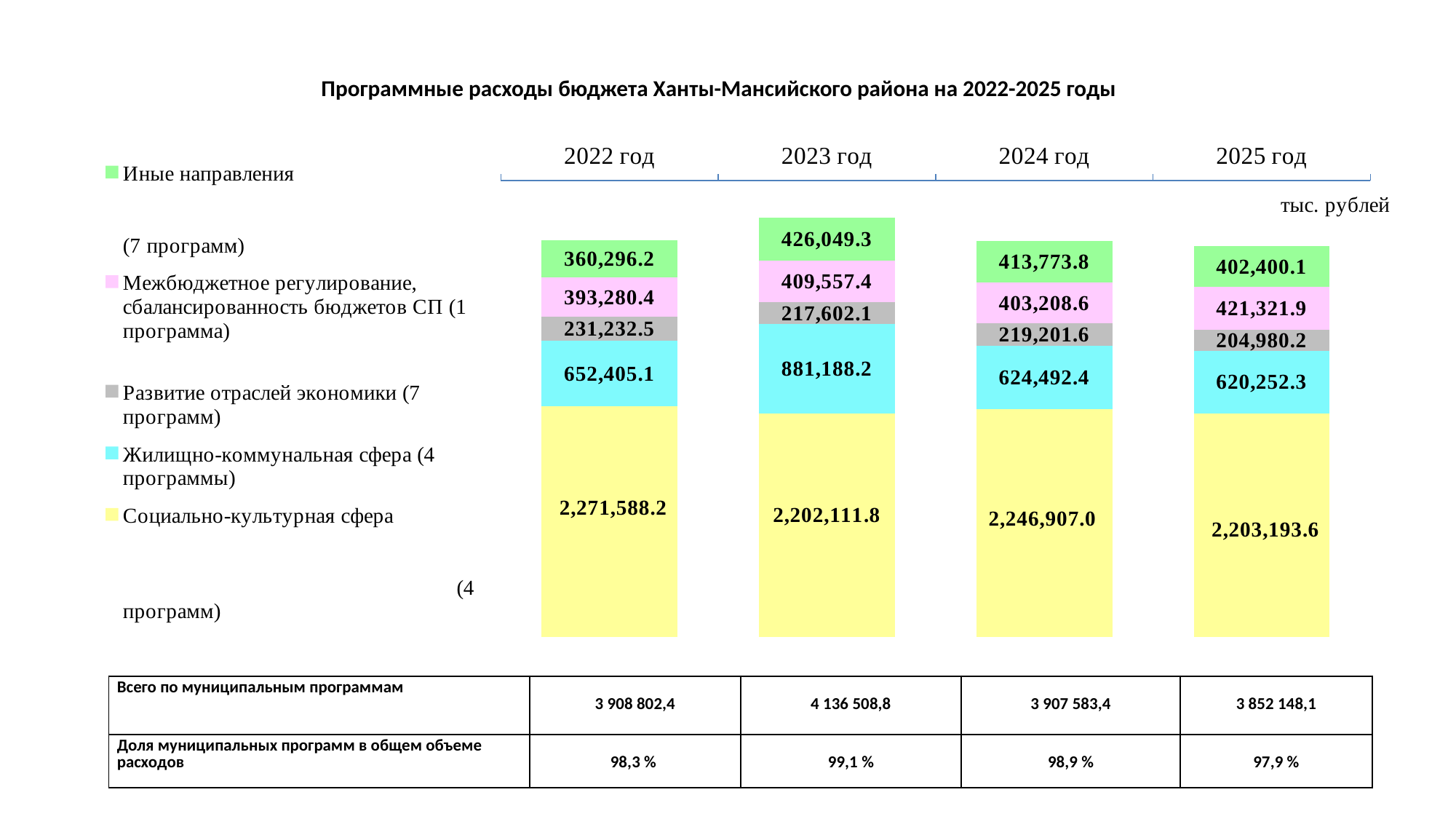
In which year is the value for Иные направления the highest? 2023 год In which year is the value for Развитие отраслей экономики the lowest? 2025 год What colour represents Социально-культурная сфера in the chart? Yellow What kind of chart is shown on the slide? Stacked bar chart What is the value for Социально-культурная сфера in 2025 год? 2,203,193.6 What is the total of the stacked bar for 2022 год? 3 908 802,4 What is the value for Развитие отраслей экономики in 2022 год? 231,232.5 How many series does the legend list? 5 What is the difference between the Жилищно-коммунальная сфера values for 2023 год and 2022 год? 228,783.1 What is the value for Жилищно-коммунальная сфера in 2023 год? 881,188.2 Which is larger in 2025 год: Межбюджетное регулирование, сбалансированность бюджетов СП or Иные направления? Межбюджетное регулирование, сбалансированность бюджетов СП How many years (bars) are shown in the chart? 4